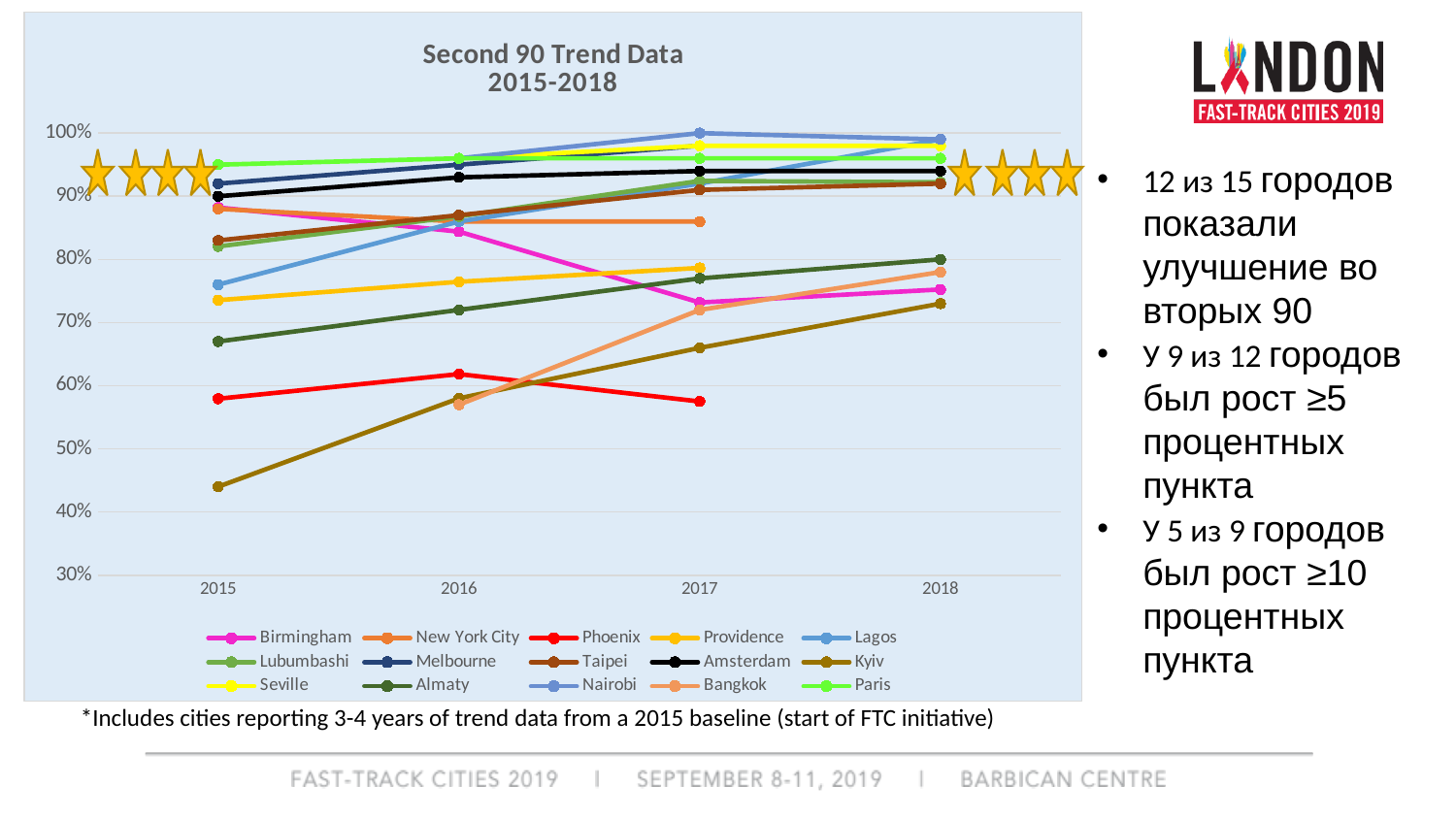
Does the value for Birmingham rise or fall from 2015 to 2018? fall How many years are shown along the x axis of the chart? 4 Which city has the lowest value in 2015? Kyiv Which city has the highest value in 2017? Nairobi Is the value for Amsterdam in 2015 greater or less than 80%? greater What is the title of the chart? Second 90 Trend Data 2015-2018 What kind of chart is shown on the slide? line chart Is the value for Almaty in 2015 greater or less than 70%? less Is the value for Kyiv in 2015 greater or less than 50%? less Does the value for Kyiv rise or fall from 2015 to 2018? rise How many series does the chart legend list? 15 In 2015, which is larger: the value for Almaty or the value for Kyiv? Almaty